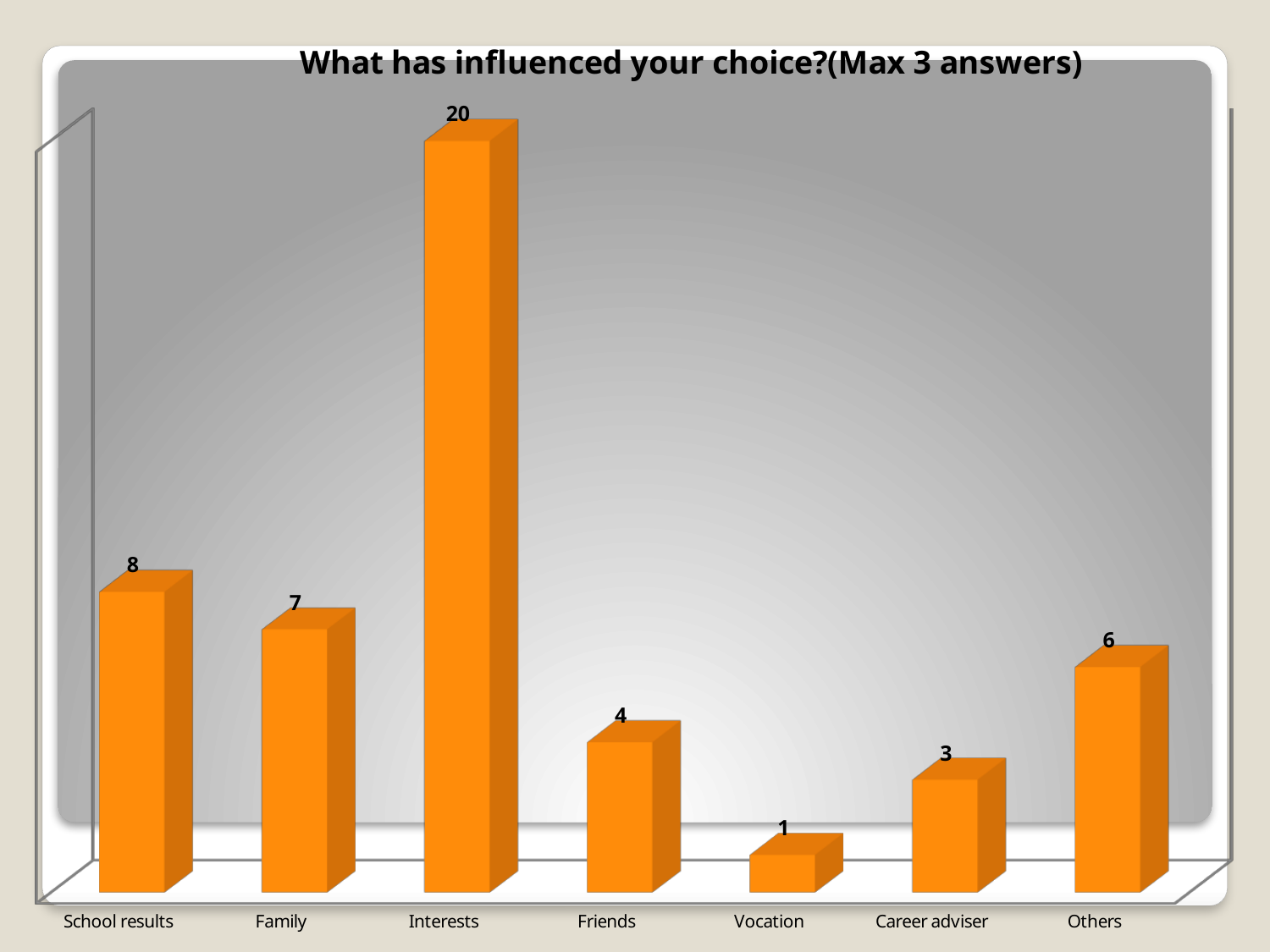
What is the difference between the values for Family and Others? 1 What is the value for Career adviser? 3 What is the value for Interests? 20 Which category has the highest value? Interests How many categories are shown on the x axis? 7 What is the difference between the values for Interests and School results? 12 Which category has the lowest value? Vocation What is the title of the chart? What has influenced your choice?(Max 3 answers) Which is larger, the value for Friends or the value for Others? Others What is the value for School results? 8 What kind of chart is shown on the slide? Bar chart What colour are the bars in the chart? Orange